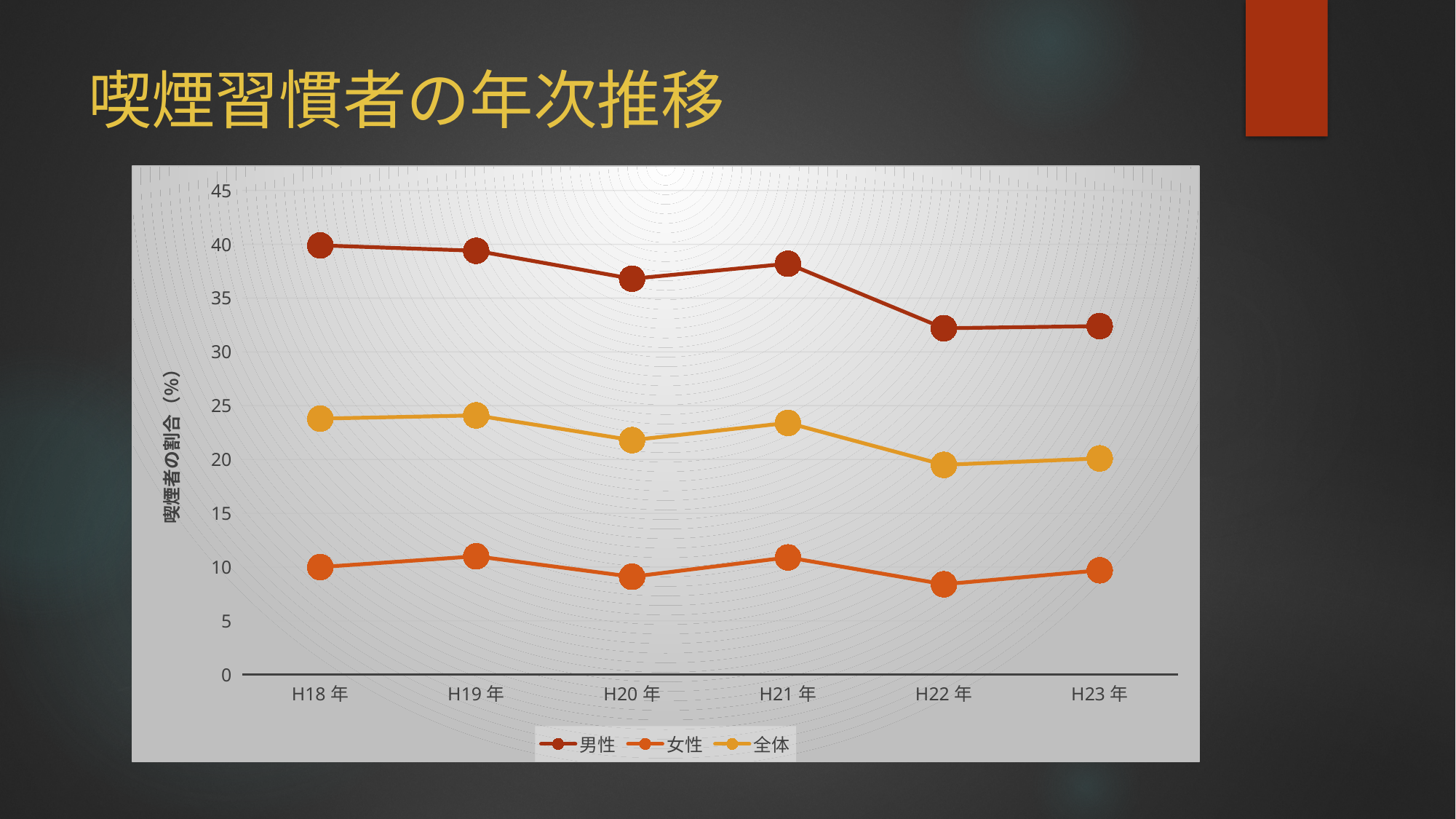
Is the value for 全体 in H18年 greater or less than 20? greater How many series does the legend list? 3 Is the value for 男性 in H22年 greater or less than 35? less Is the value for 女性 in H19年 greater or less than 10? greater In H21年, which is larger, the value for 男性 or the value for 女性? 男性 What kind of chart is shown on the slide? line chart Does the value for 男性 rise or fall overall from H18年 to H23年? fall How many years are plotted along the x axis? 6 What is the title of the chart on the slide? 喫煙習慣者の年次推移 Which series has the highest values across all years? 男性